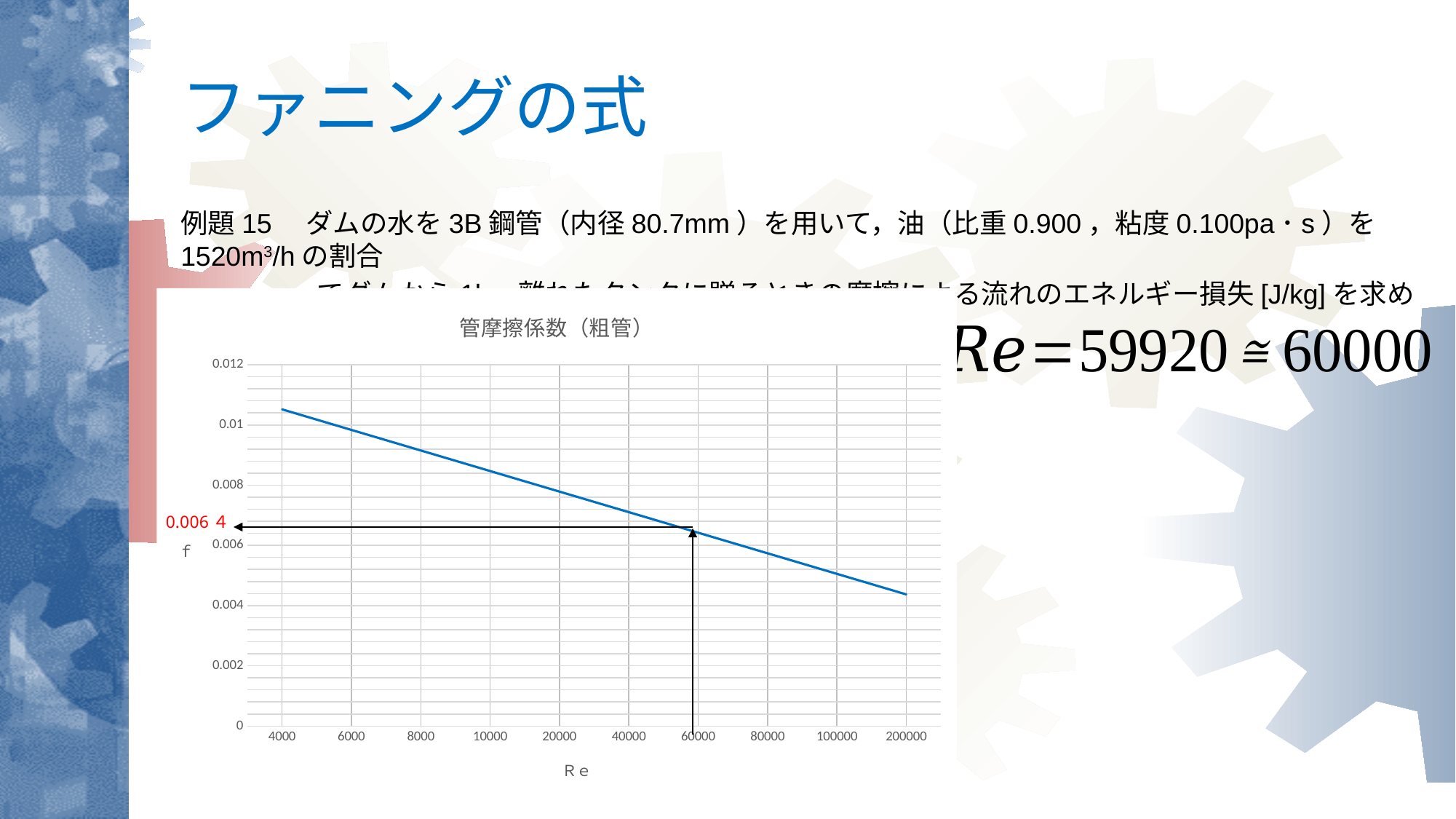
Is the value of f at Re = 200000 greater or less than 0.006? less What is the title of the chart? 管摩擦係数（粗管） How many Re values are labelled along the x axis? 10 At which Re value on the x axis is f highest? 4000 Is the value of f at Re = 4000 greater or less than 0.01? greater At which Re value on the x axis is f lowest? 200000 What kind of chart is shown on the slide? line chart Is the value of f at Re = 10000 greater or less than 0.008? greater What value of f is marked by the red annotation at Re = 60000? 0.0064 Which has the larger f value, Re = 4000 or Re = 200000? 4000 What is the label of the x axis of the chart? Ｒｅ Does the value of f rise or fall as Re increases along the x axis? fall